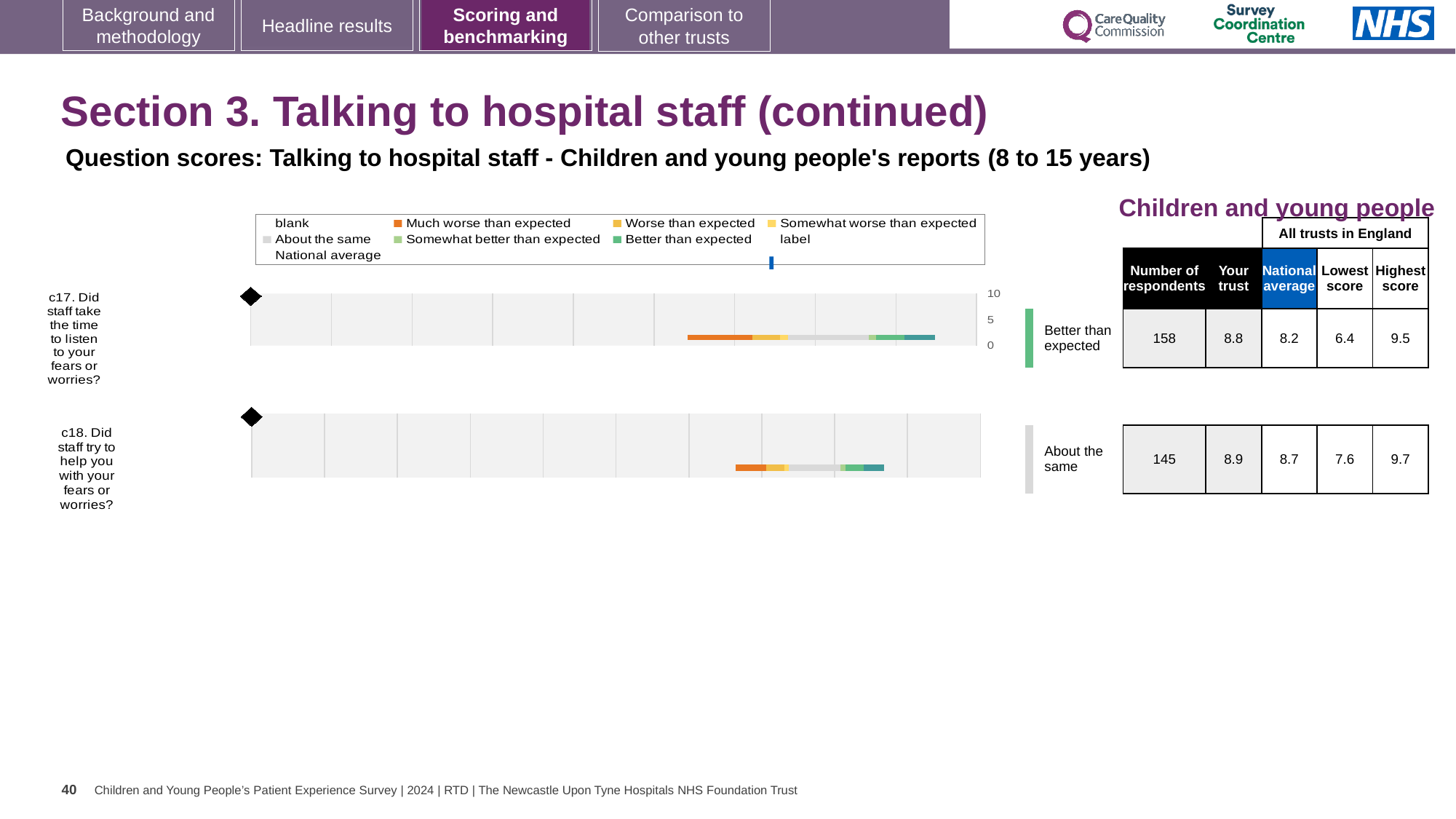
What kind of chart is used to show the question scores for c17 and c18? bar chart What is the 'Your trust' score for c17 (Did staff take the time to listen to your fears or worries?)? 8.8 What is the lowest score across all trusts in England for c17? 6.4 How many questions are plotted in the chart? 2 What is the highest score across all trusts in England for c18? 9.7 What benchmark category is shown for c17? Better than expected Which question has the higher 'Your trust' score, c17 or c18? c18 Is the trust's score for c17 greater or less than 5 on the chart axis? greater By how much does the trust's score for c17 exceed the national average for c17? 0.6 What is the difference between the highest and lowest scores for c18? 2.1 What is the national average score for c18 (Did staff try to help you with your fears or worries?)? 8.7 How many respondents answered c17? 158